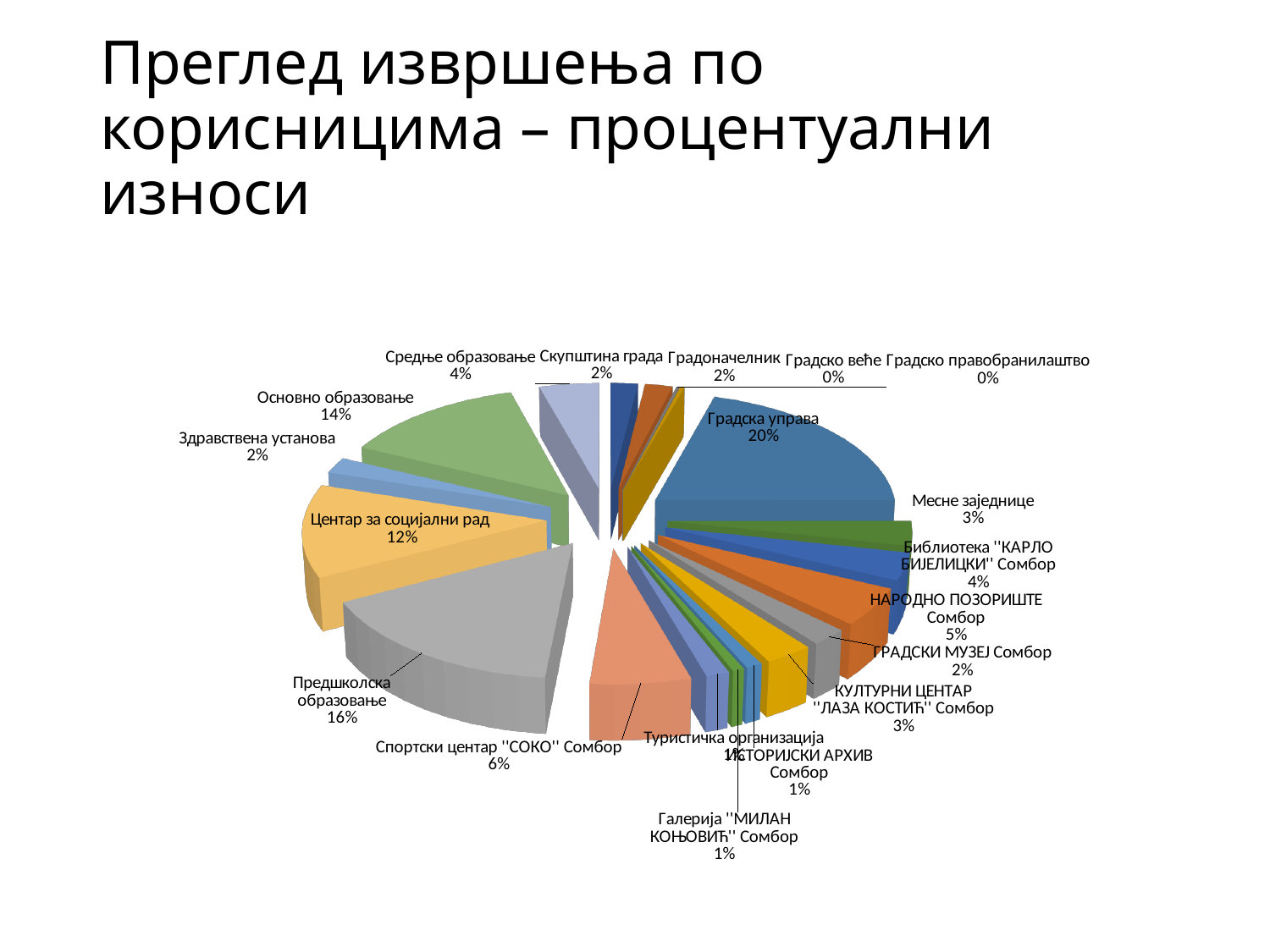
What type of chart is shown on the slide? Pie chart Which category has the largest share of the pie? Градска управа What percentage is shown for Центар за социјални рад? 12% What percentage is shown for Основно образовање? 14% What percentage is shown for Предшколска образовање? 16% What percentage share does Градска управа have in the pie chart? 20% What is the title of the slide? Преглед извршења по корисницима – процентуални износи What percentage is shown for НАРОДНО ПОЗОРИШТЕ Сомбор? 5% What is the difference between the share for Градска управа and the share for Предшколска образовање? 4% How many categories are shown in the pie chart? 19 What percentage is shown for Спортски центар ''СОКО'' Сомбор? 6% Which is larger, the share for Основно образовање or the share for Центар за социјални рад? Основно образовање